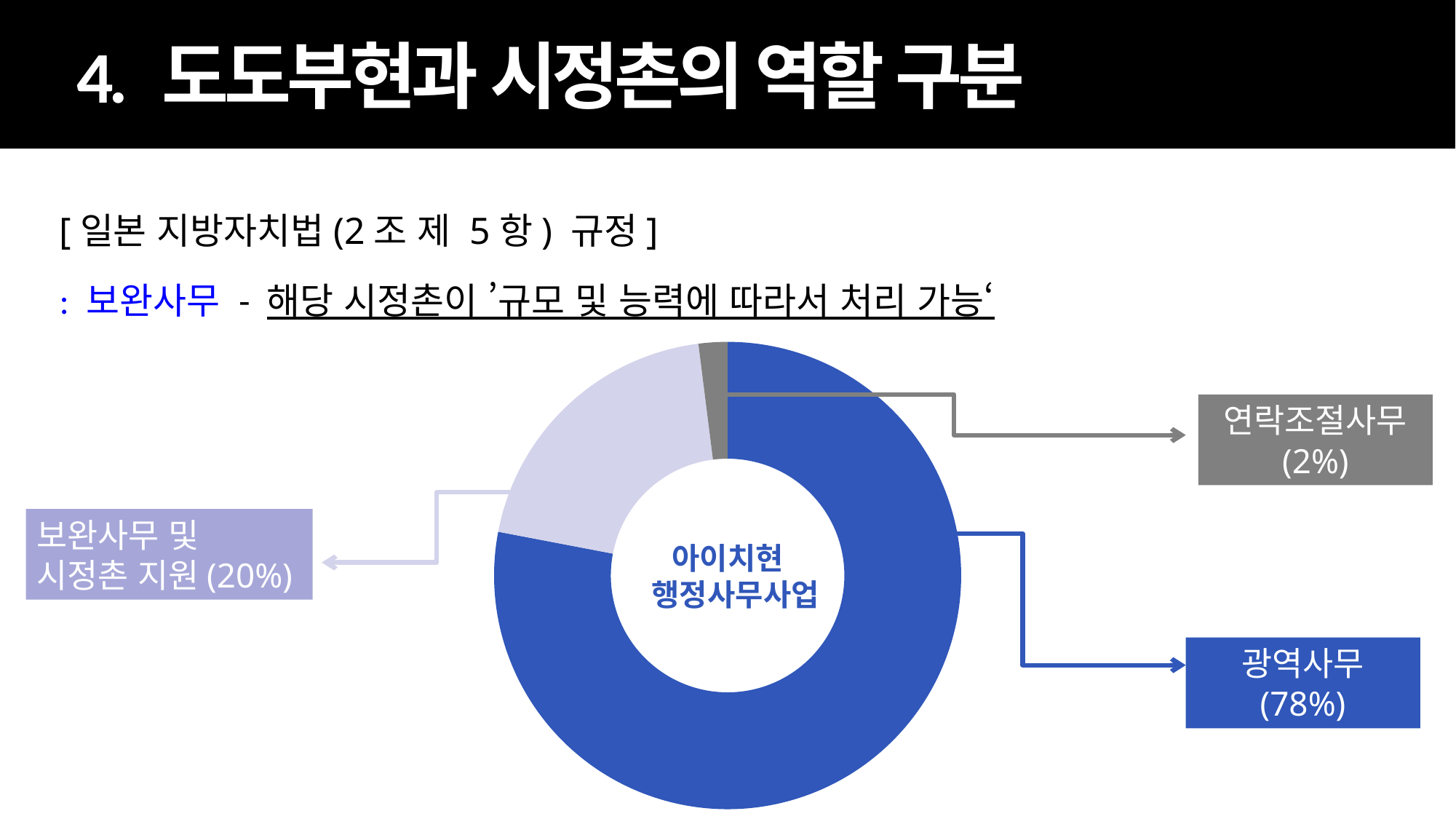
Which is larger, the share for 보완사무 및 시정촌 지원 or the share for 연락조절사무? 보완사무 및 시정촌 지원 What is the share for 연락조절사무 in the chart? 2% Which category has the largest share in the chart? 광역사무 What is the difference in percentage points between 보완사무 및 시정촌 지원 and 연락조절사무? 18 What is the difference in percentage points between 광역사무 and 보완사무 및 시정촌 지원? 58 Which category has the smallest share in the chart? 연락조절사무 What colour is the slice for 연락조절사무? Grey What text appears in the centre of the donut chart? 아이치현 행정사무사업 How many categories (slices) does the chart show? 3 What kind of chart is shown on the slide? Donut (pie) chart What is the share for 보완사무 및 시정촌 지원 in the chart? 20% What is the share for 광역사무 in the 아이치현 행정사무사업 chart? 78%